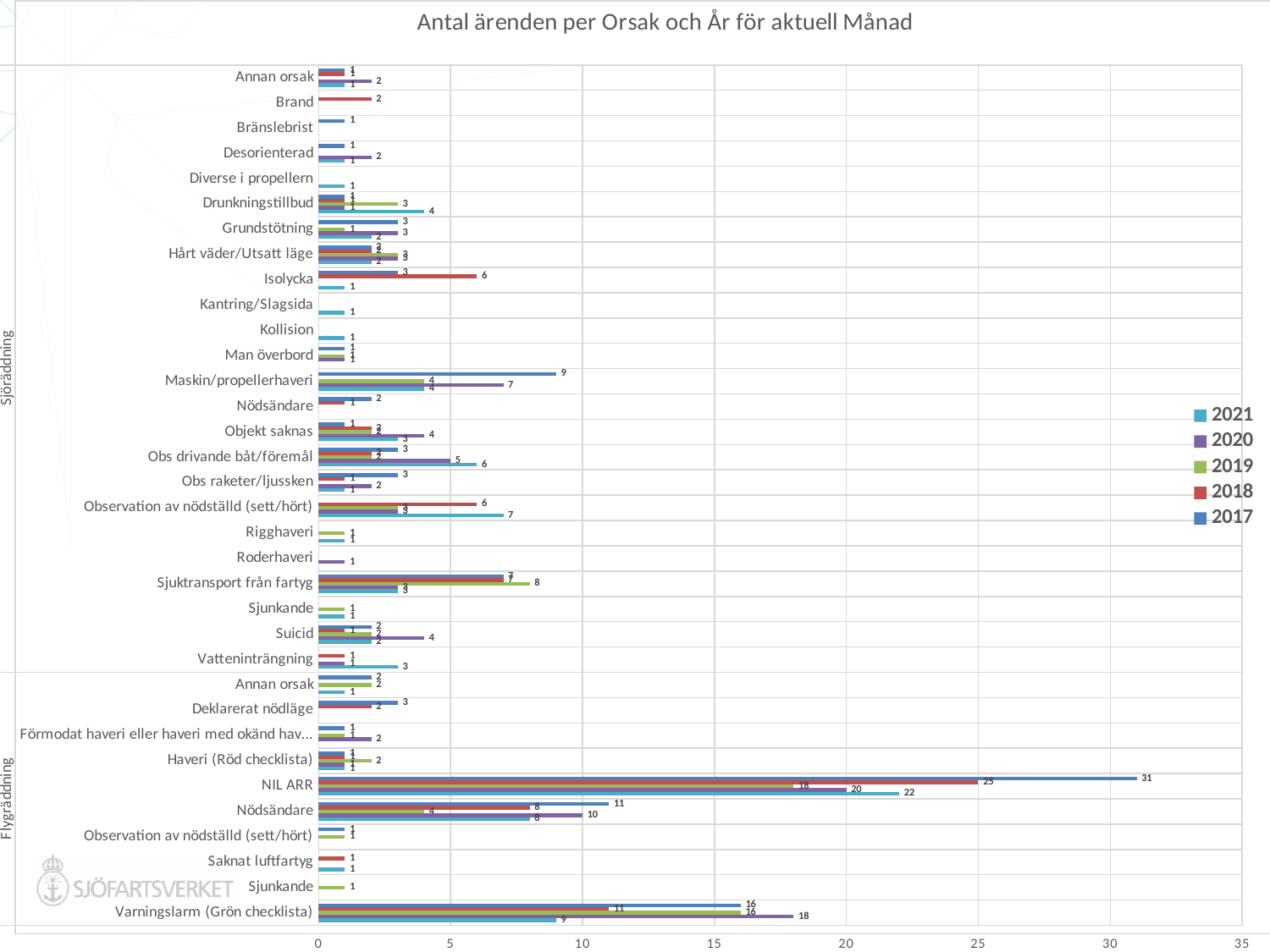
What is the value for Varningslarm (Grön checklista) in 2020? 18 What is the value for Isolycka in 2018? 6 What is the difference between the NIL ARR values for 2017 and 2018? 6 For Maskin/propellerhaveri, which year has the larger value, 2017 or 2020? 2017 How many series does the legend list? 5 What is the value for NIL ARR in 2017? 31 Which category and year has the highest value in the chart? NIL ARR, 2017 What kind of chart is shown on the slide? bar chart Is the value for NIL ARR in 2021 greater or less than 20? greater What is the value for Sjuktransport från fartyg in 2019? 8 What is the value for Nödsändare under Flygräddning in 2017? 11 What is the title of the chart? Antal ärenden per Orsak och År för aktuell Månad